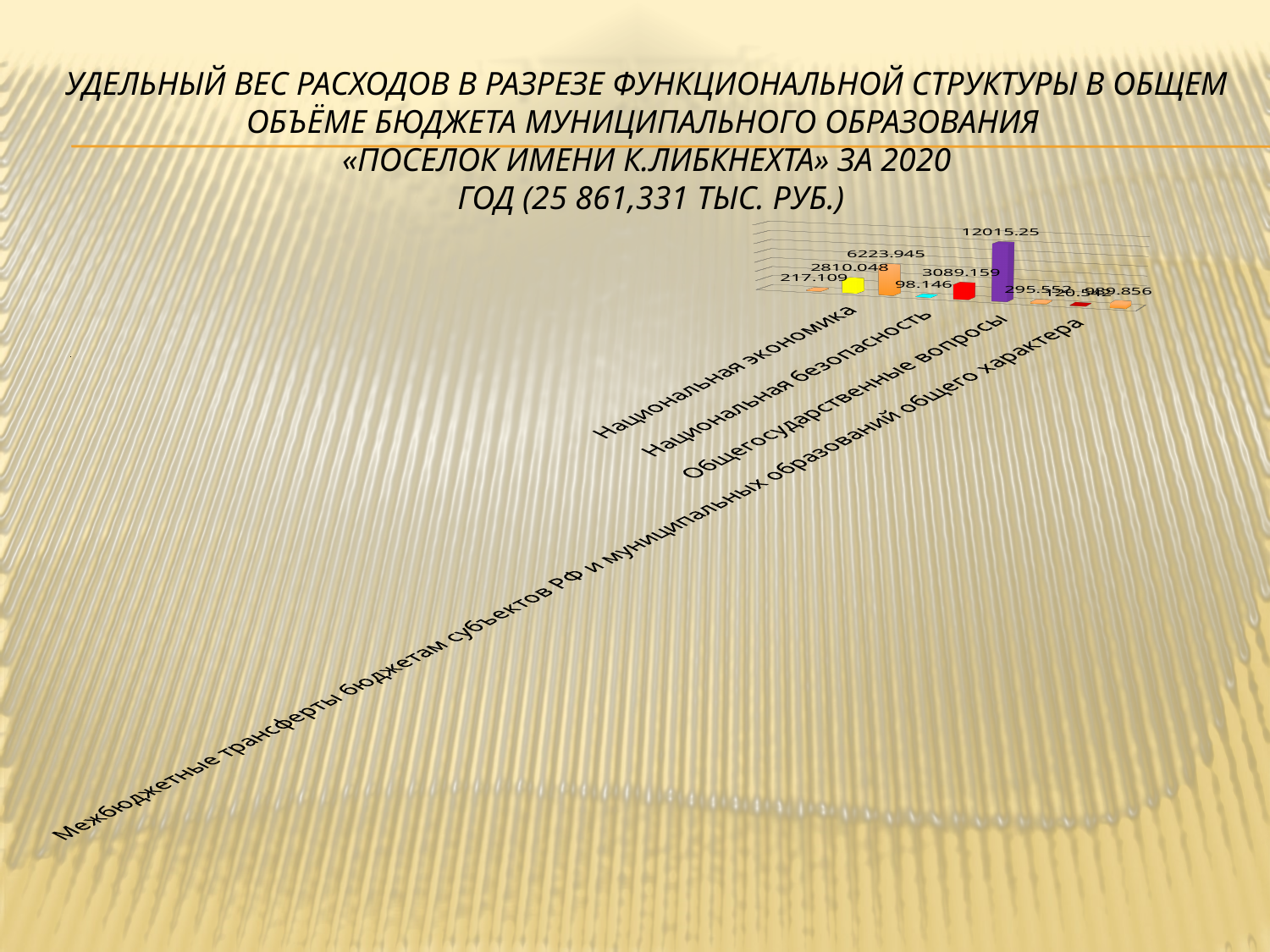
What is the value of the yellow bar on the chart? 2810.048 Which is larger: the bar labelled 6223.945 or the bar labelled 3089.159? 6223.945 What kind of chart is shown on the slide? Bar chart What is the difference between the highest labelled value (12015.25) and the second highest (6223.945)? 5791.305 What is the lowest value labelled on the chart? 98.146 What total budget amount is stated in the slide title? 25 861,331 тыс. руб. What is the highest value labelled on the chart? 12015.25 What is the difference between the bars labelled 3089.159 and 2810.048? 279.111 What colour is the tallest bar on the chart? Purple What is the value of the red bar on the chart? 3089.159 Which is larger: the bar labelled 217.109 or the bar labelled 295.552? 295.552